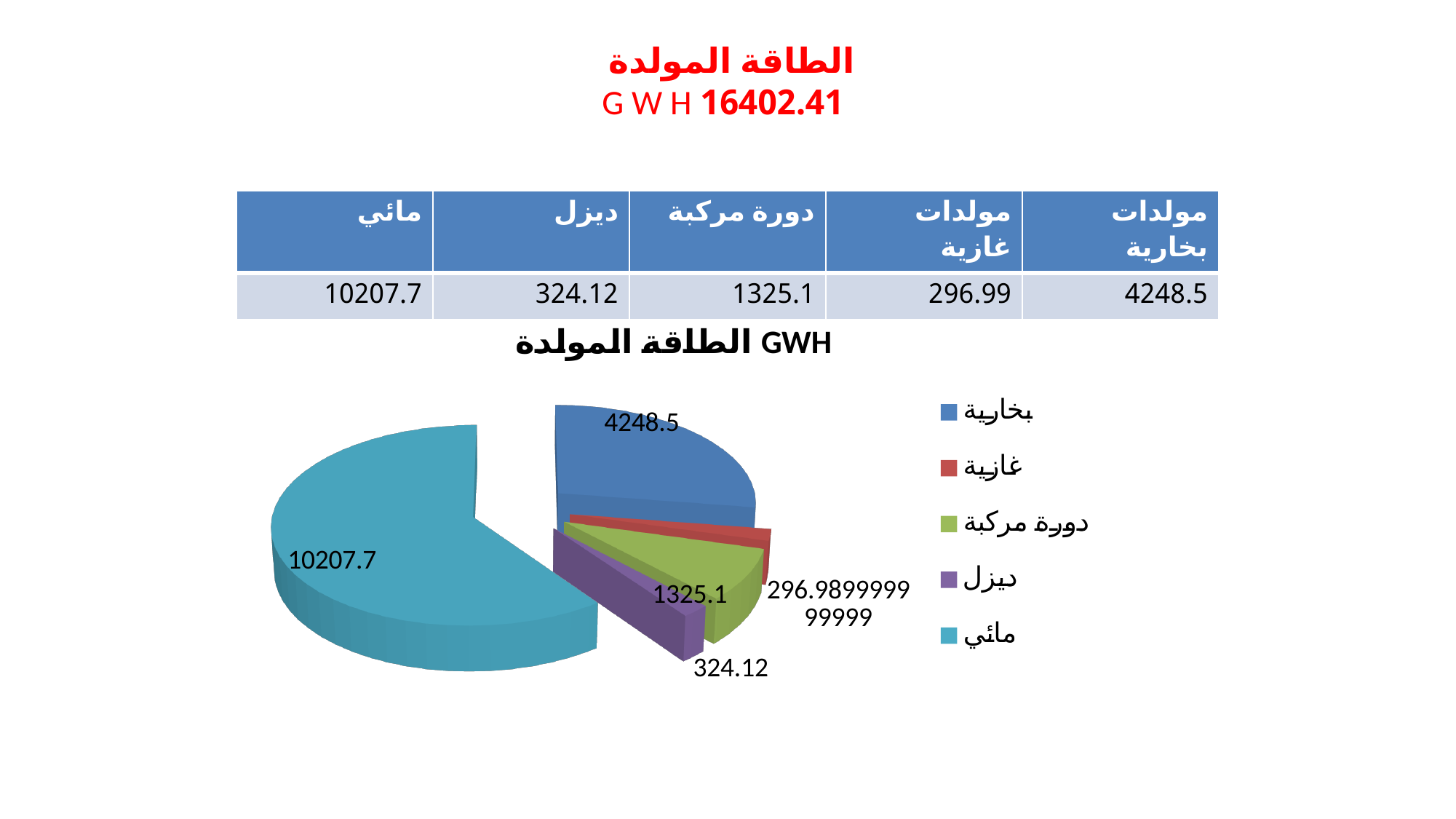
What is the title of the chart? الطاقة المولدة GWH How many slices does the pie chart have? 5 What is the difference between the values for دورة مركبة and ديزل in the pie chart? 1000.98 Which category has the largest slice in the pie chart? مائي In the pie chart, what is the value for بخارية? 4248.5 In the pie chart, what is the value for ديزل? 324.12 In the pie chart, what is the value for دورة مركبة? 1325.1 In the pie chart, which is larger: بخارية or دورة مركبة? بخارية In the pie chart, what is the value for مائي? 10207.7 What is the difference between the values for مائي and بخارية in the pie chart? 5959.2 Which category has the smallest slice in the pie chart? غازية What type of chart is shown on the slide? Pie chart